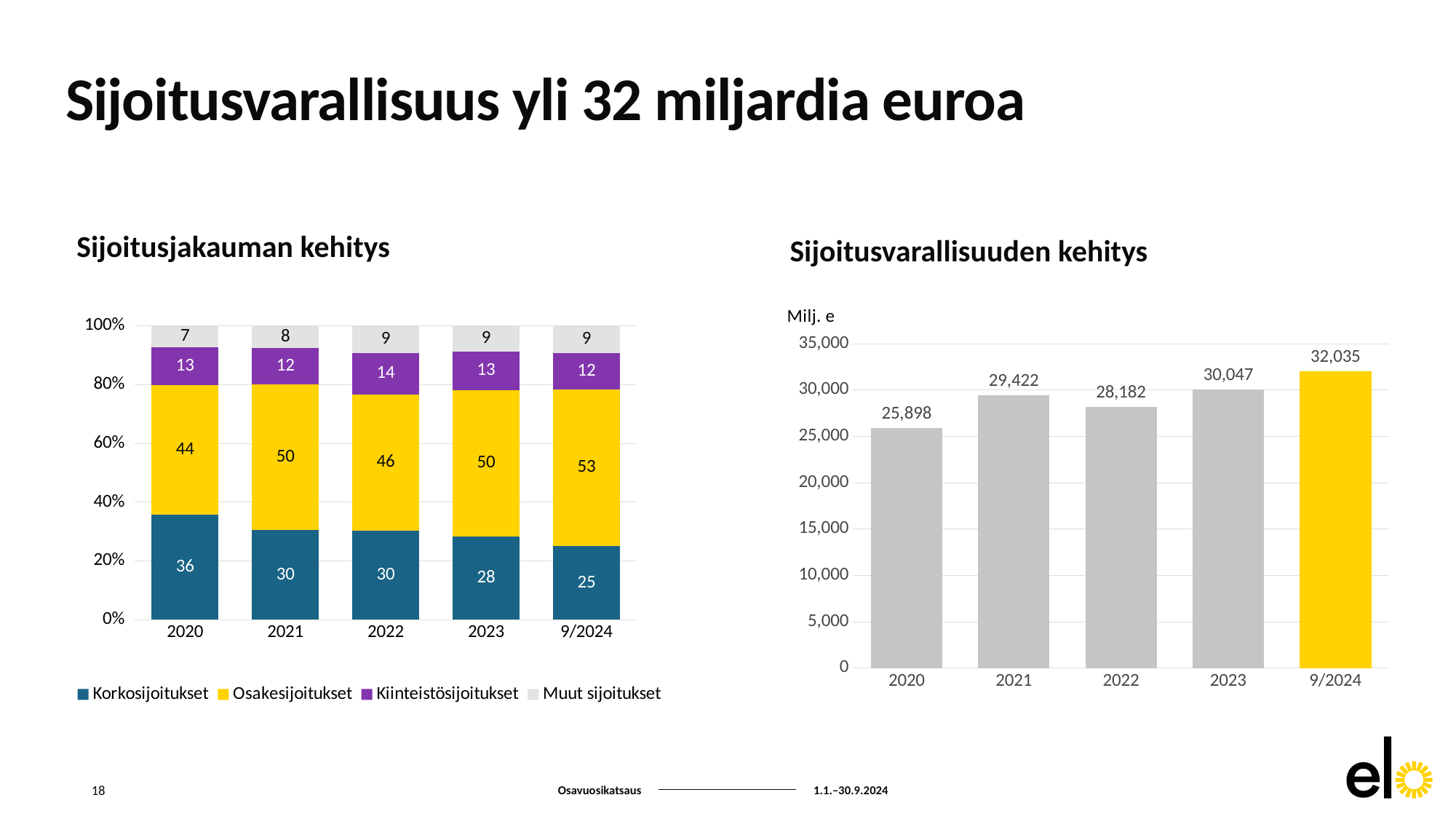
In the 'Sijoitusjakauman kehitys' chart, does the Korkosijoitukset share rise or fall from 2020 to 9/2024? fall In the 'Sijoitusvarallisuuden kehitys' chart, which is larger, the value for 2021 or the value for 2022? 2021 In the 'Sijoitusjakauman kehitys' chart, how many series does the legend list? 4 What kind of chart is 'Sijoitusvarallisuuden kehitys'? bar chart In the 'Sijoitusvarallisuuden kehitys' chart, which year has the lowest value? 2020 In the 'Sijoitusjakauman kehitys' chart, what is the Korkosijoitukset value for 2020? 36 In the 'Sijoitusvarallisuuden kehitys' chart, how many bars are plotted? 5 In the 'Sijoitusvarallisuuden kehitys' chart, what is the difference between the 9/2024 value and the 2023 value? 1,988 In the 'Sijoitusjakauman kehitys' chart, in which year is the Korkosijoitukset share highest? 2020 In the 'Sijoitusjakauman kehitys' chart, what is the Osakesijoitukset value for 9/2024? 53 In the 'Sijoitusvarallisuuden kehitys' chart, what is the value for 9/2024? 32,035 In the 'Sijoitusvarallisuuden kehitys' chart, what is the value for 2020? 25,898